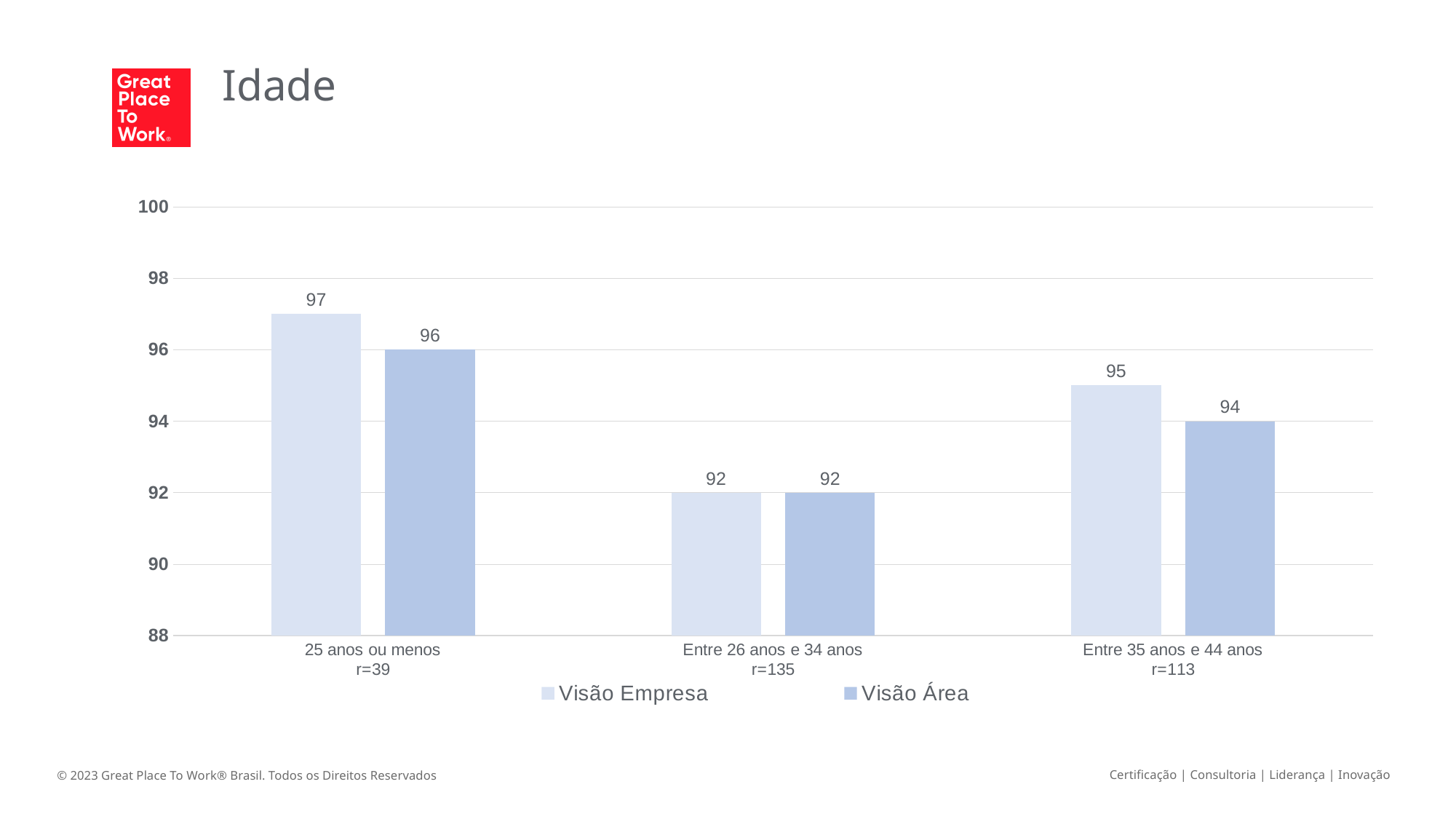
What is the difference between the Visão Empresa values for '25 anos ou menos' and 'Entre 26 anos e 34 anos'? 5 What is the Visão Área value for 'Entre 26 anos e 34 anos'? 92 How many age groups are shown on the x axis? 3 Which is larger: the Visão Empresa value for 'Entre 35 anos e 44 anos' or the Visão Área value for '25 anos ou menos'? Visão Área value for '25 anos ou menos' What kind of chart is shown on the slide? Bar chart What is the title of the slide? Idade How many series does the legend list? 2 What is the Visão Empresa value for '25 anos ou menos'? 97 What is the difference between the Visão Empresa and Visão Área values for '25 anos ou menos'? 1 Which age group has the lowest Visão Área value? Entre 26 anos e 34 anos What is the Visão Área value for 'Entre 35 anos e 44 anos'? 94 Which age group has the highest Visão Empresa value? 25 anos ou menos